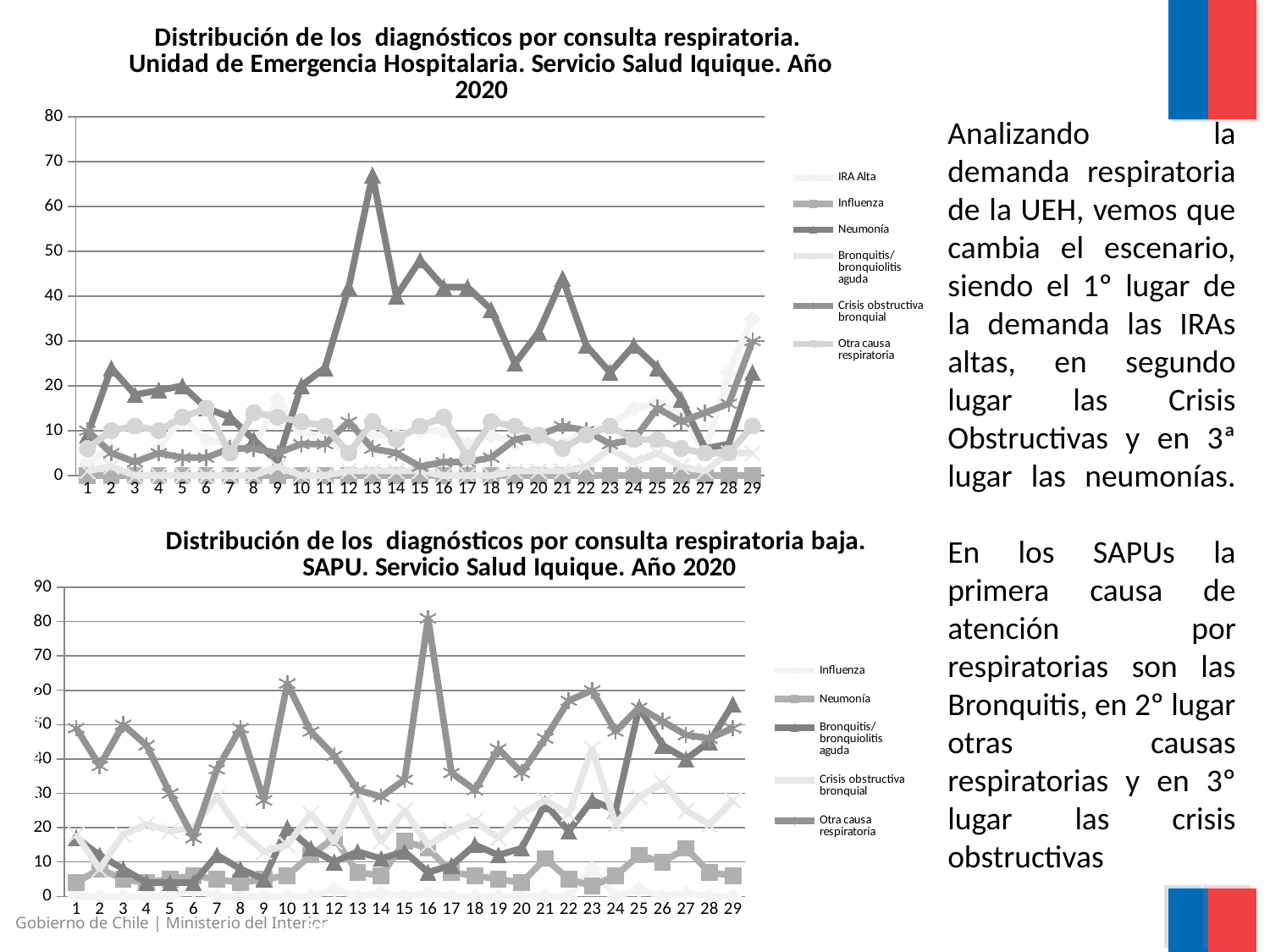
How many series does the legend of the bottom chart (SAPU) list? 5 In the top chart (Unidad de Emergencia Hospitalaria), is the highest plotted value greater or less than 60? greater What kind of chart is the top chart, 'Distribución de los diagnósticos por consulta respiratoria. Unidad de Emergencia Hospitalaria'? Line chart How many series does the legend of the top chart (Unidad de Emergencia Hospitalaria) list? 6 How many points are there along the x axis of the bottom chart (SAPU)? 29 What is the maximum value shown on the y axis of the bottom chart (SAPU)? 90 In the bottom chart (SAPU), is the highest plotted value greater or less than 70? greater What kind of chart is the bottom chart, 'Distribución de los diagnósticos por consulta respiratoria baja. SAPU'? Line chart Which series appears first in the legend of the top chart (Unidad de Emergencia Hospitalaria)? IRA Alta How many points are there along the x axis of the top chart (Unidad de Emergencia Hospitalaria)? 29 In the bottom chart (SAPU), at which x-axis point does the highest value of any series occur? 16 In the top chart (Unidad de Emergencia Hospitalaria), at which x-axis point does the highest value of any series occur? 13